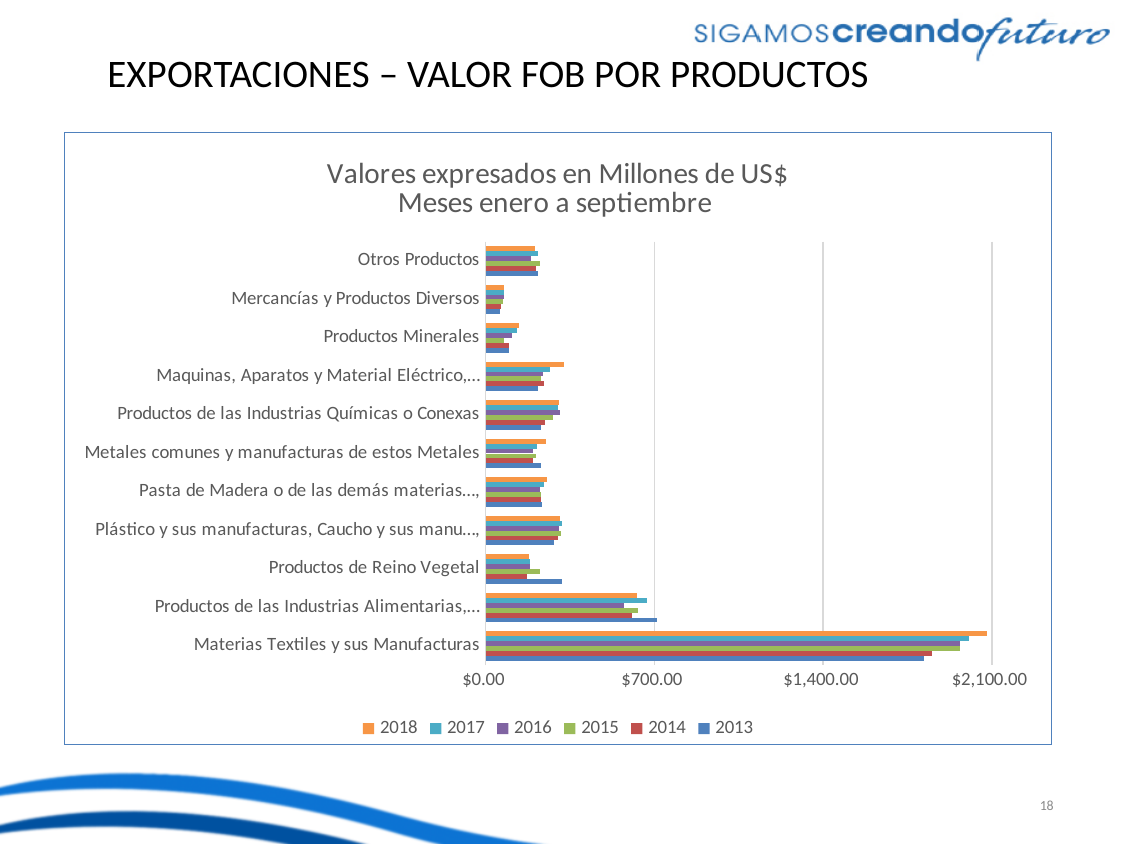
How many series does the legend list? 6 Which is larger, the 2018 value for Productos Minerales or the 2018 value for Mercancías y Productos Diversos? Productos Minerales Which product category has the highest export value? Materias Textiles y sus Manufacturas What is the title of the chart? Valores expresados en Millones de US$ Meses enero a septiembre For Productos de Reino Vegetal, which year has the highest value? 2013 Which product category has the lowest export value? Mercancías y Productos Diversos What kind of chart is shown on the slide? bar chart Which is larger, the 2018 value for Materias Textiles y sus Manufacturas or the 2018 value for Productos de las Industrias Alimentarias? Materias Textiles y sus Manufacturas How many product categories are shown on the chart? 11 Is the 2018 value for Otros Productos greater or less than $700.00? less Is the 2018 value for Materias Textiles y sus Manufacturas greater or less than $1,400.00? greater For Materias Textiles y sus Manufacturas, which year has the highest value? 2018